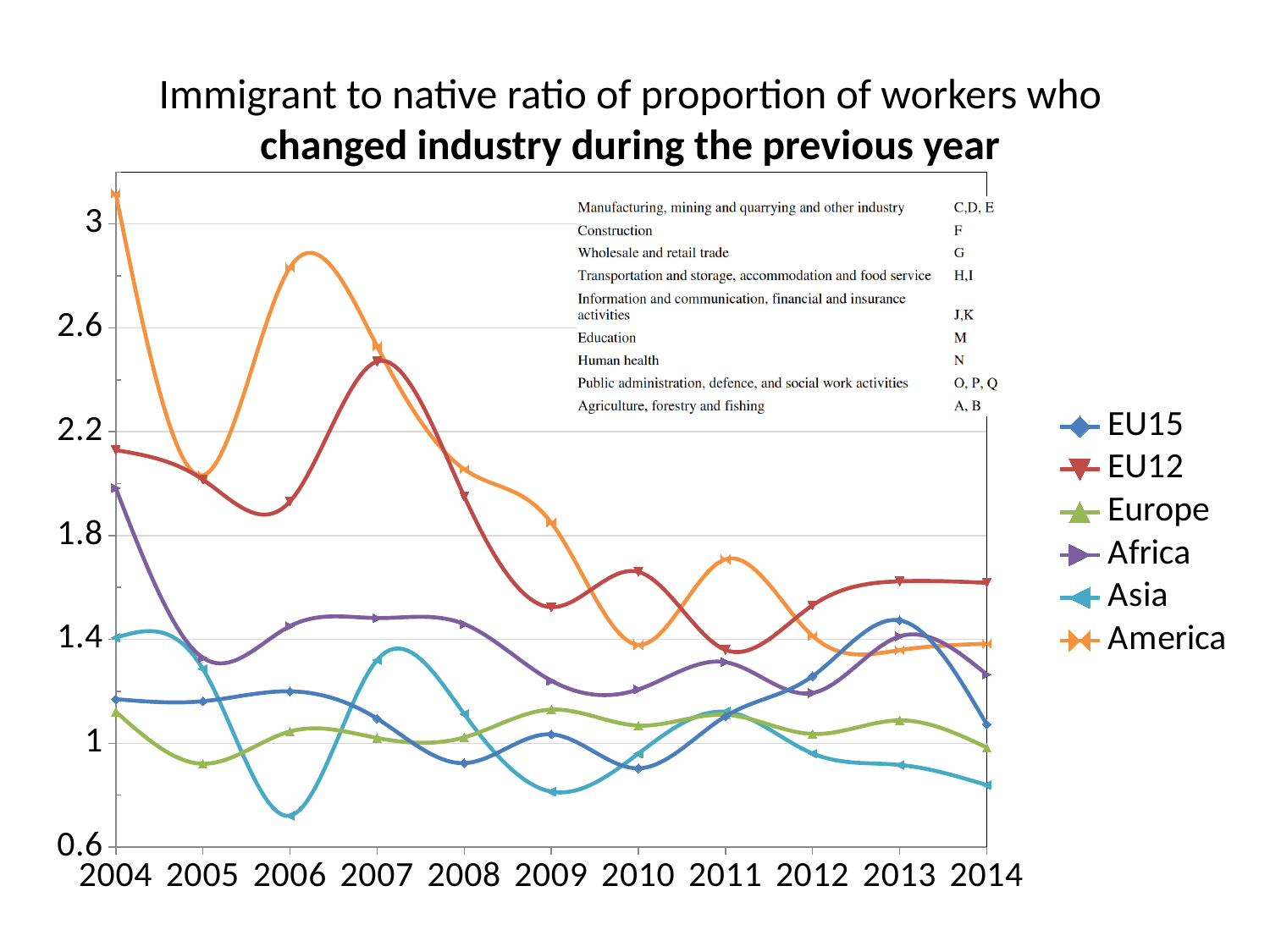
Is the value for Asia in 2006 greater or less than 1? less Which series has the highest value in 2004? America Which series has the lowest value in 2006? Asia Is the value for America in 2004 greater or less than 3? greater What kind of chart is shown on the slide? line chart In 2010, which is larger: the value for EU12 or the value for America? EU12 What is the title of the chart? Immigrant to native ratio of proportion of workers who changed industry during the previous year Does the America series overall rise or fall from 2004 to 2014? fall How many series does the legend list? 6 Which series has the highest value in 2014? EU12 Is the value for EU12 in 2007 greater or less than 2.2? greater How many years are shown along the x axis? 11